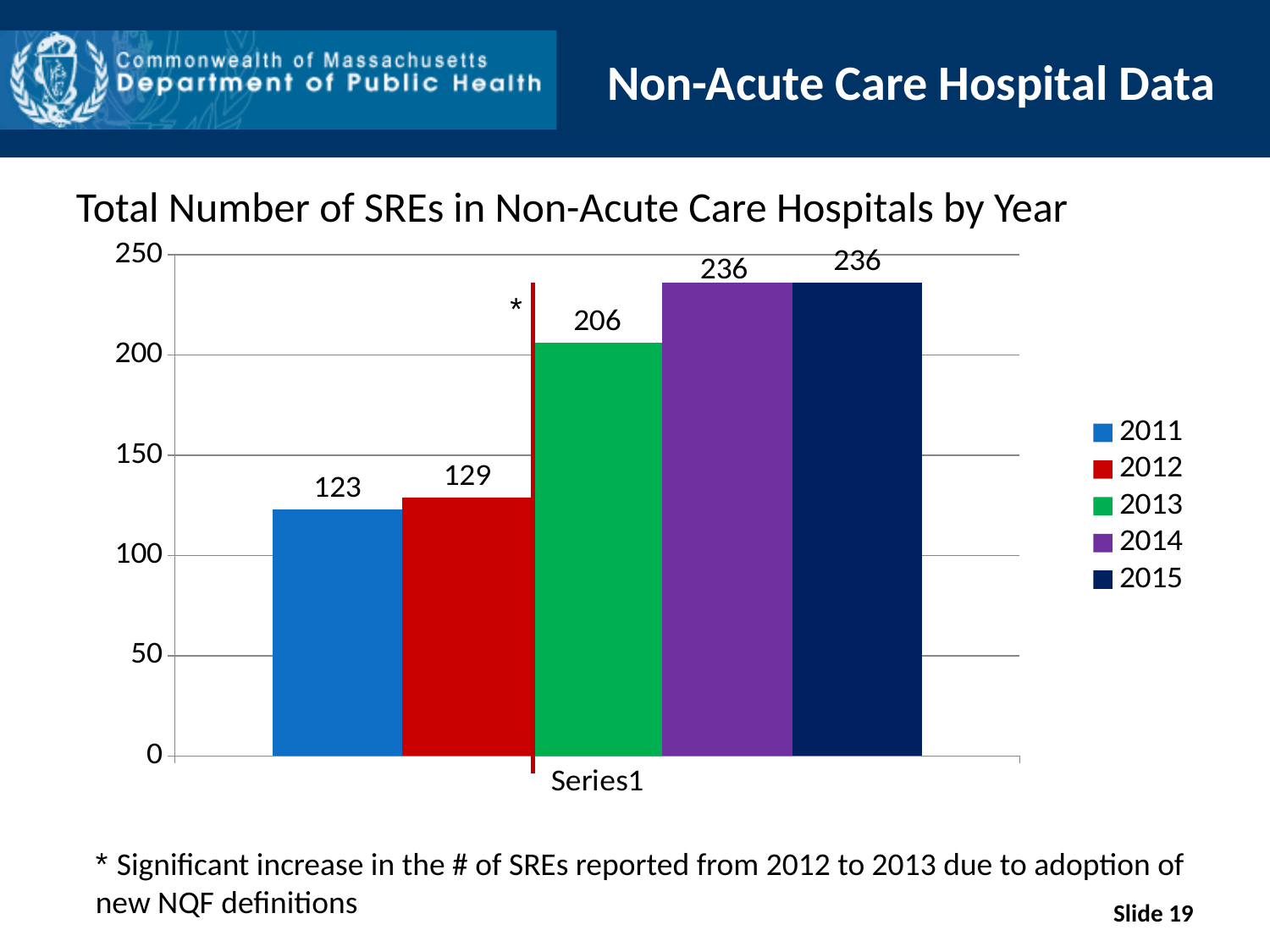
What is the difference in the number of SREs between 2014 and 2011? 113 What kind of chart is shown on the slide? bar chart What is the total number of SREs in non-acute care hospitals for 2011? 123 What is the title of the chart? Total Number of SREs in Non-Acute Care Hospitals by Year What is the total number of SREs in non-acute care hospitals for 2015? 236 How many series does the legend list? 5 What is the difference in the number of SREs between 2013 and 2012? 77 What is the total number of SREs in non-acute care hospitals for 2013? 206 Which year has the lowest number of SREs in the chart? 2011 Which year had more SREs, 2012 or 2013? 2013 Do the number of SREs generally rise or fall from 2011 to 2015? rise Is the value for 2012 greater or less than 150? less